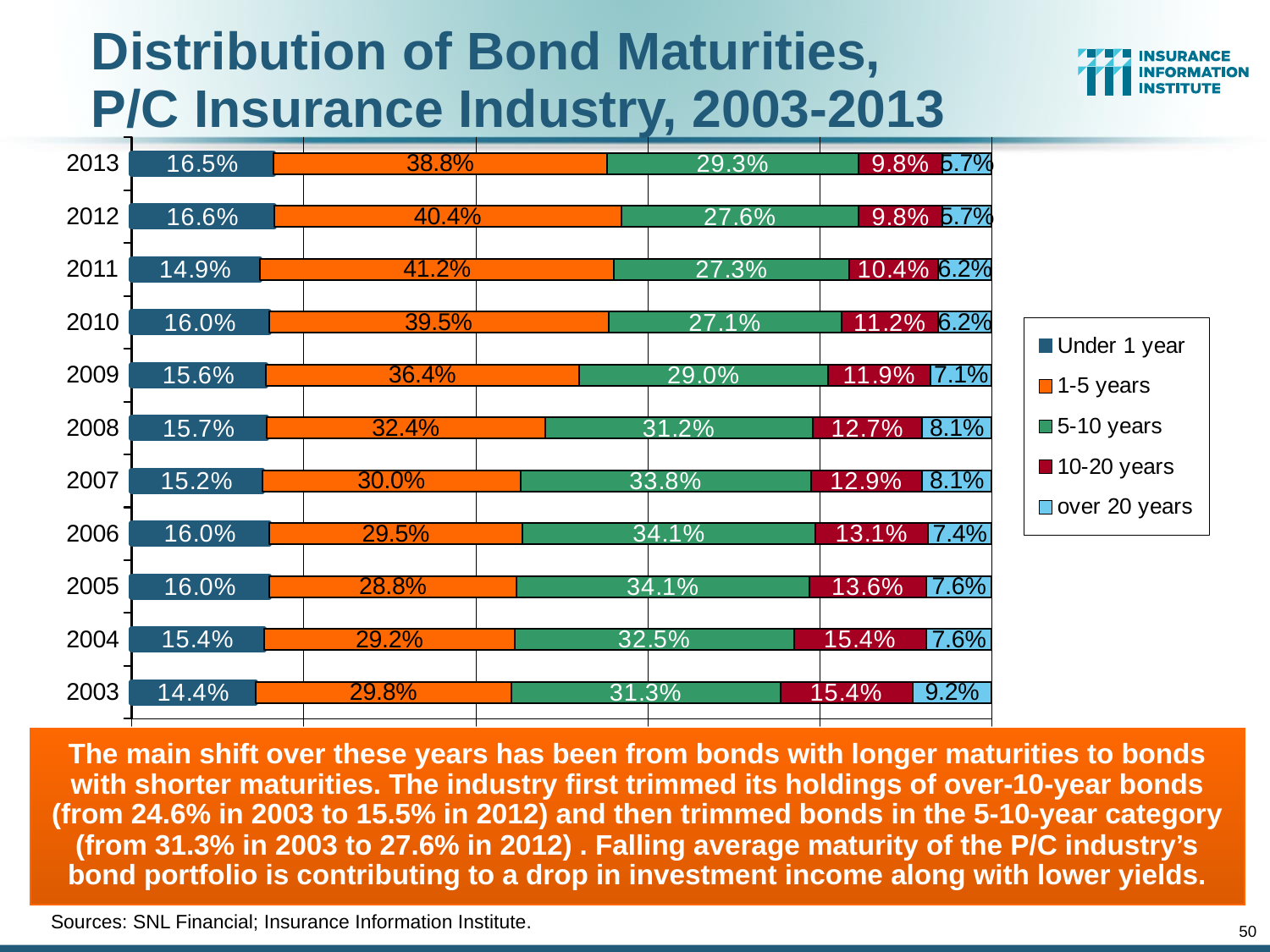
Which was larger in 2007: the 1-5 years share or the 5-10 years share? 5-10 years What was the 10-20 years share in 2008? 12.7% How much larger was the 1-5 years share in 2013 than in 2003? 9.0 percentage points How many years are shown on the chart? 11 What share of bonds had a 1-5 year maturity in 2013? 38.8% In which year was the Under 1 year share the lowest? 2003 What was the over 20 years share in 2003? 9.2% What was the 5-10 years share in 2003? 31.3% In which year was the 1-5 years share the highest? 2011 What type of chart is shown on the slide? Stacked bar chart How many maturity categories does the legend list? 5 Did the 10-20 years share rise or fall from 2003 to 2013? Fall